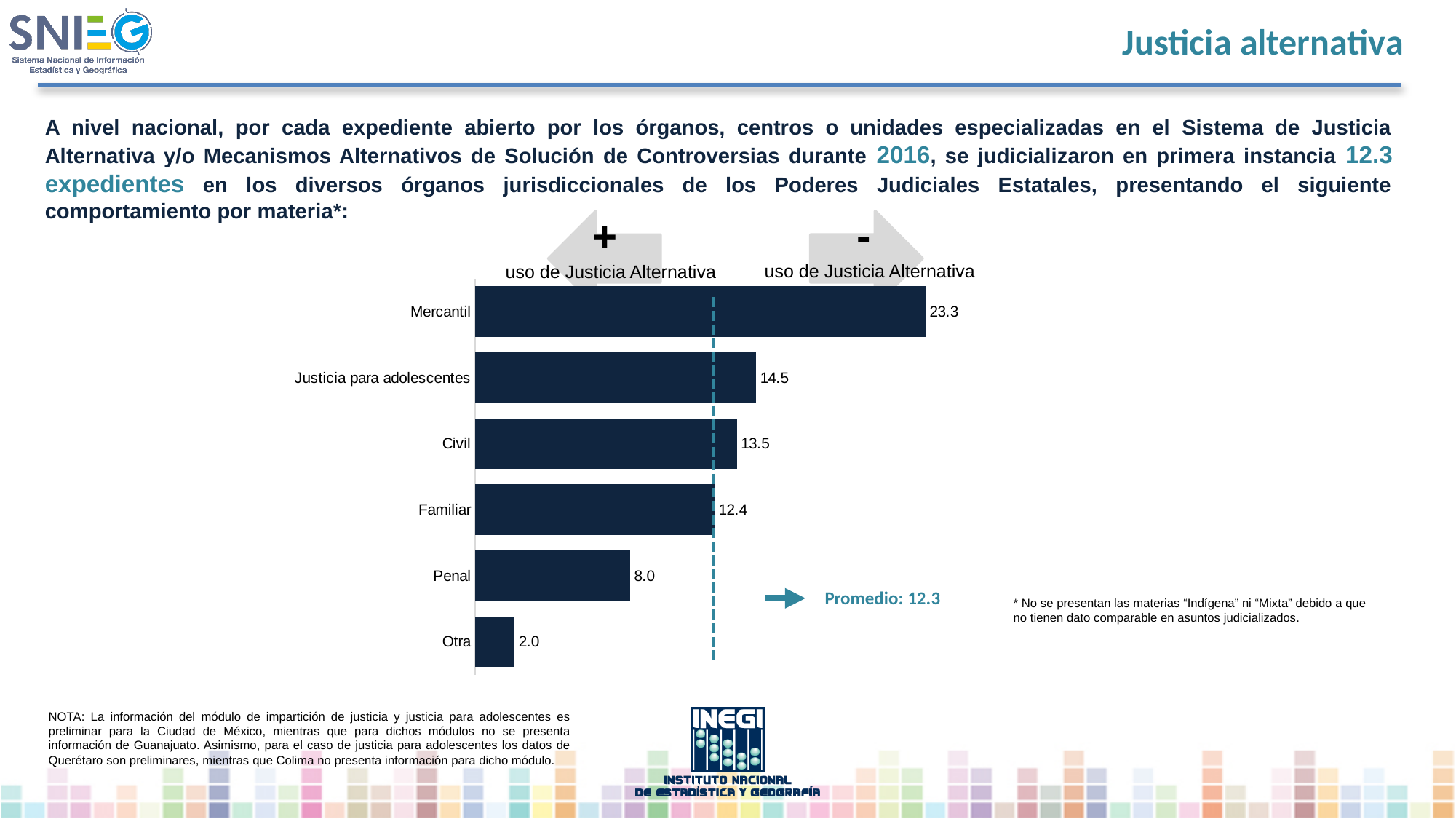
Which category has the lowest value? Otra What is the difference between the values for Familiar and Penal? 4.4 What is the difference between the values for Mercantil and Civil? 9.8 How many categories are shown in the chart? 6 What is the value for Mercantil? 23.3 What average value (Promedio) is marked by the dashed line on the chart? 12.3 What is the value for Otra? 2.0 Which category has the highest value? Mercantil Which is larger, the value for Civil or the value for Familiar? Civil What kind of chart is shown on the slide? Bar chart What is the value for Justicia para adolescentes? 14.5 What is the value for Penal? 8.0